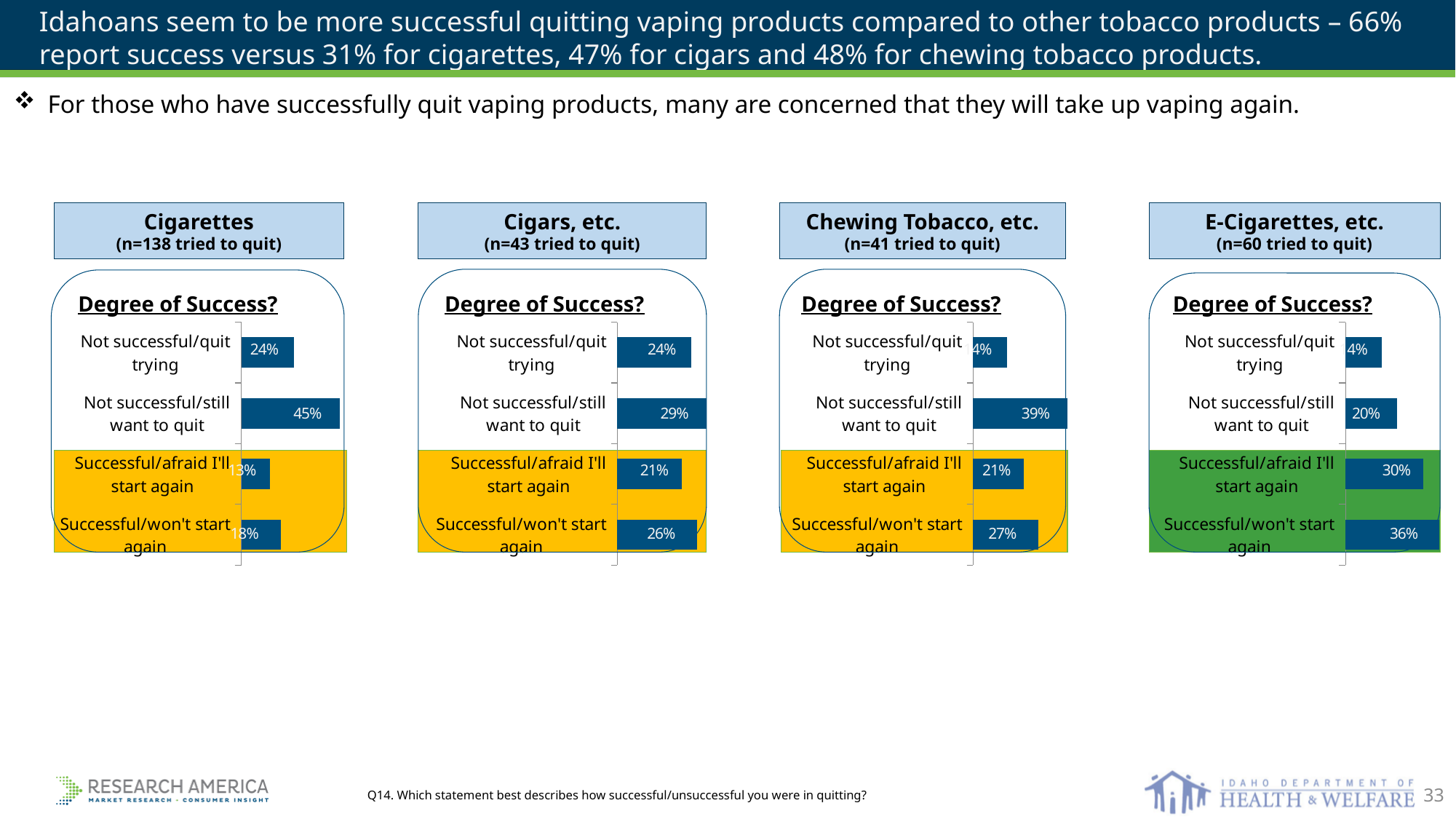
In the E-Cigarettes, etc. chart, what percentage were successful and won't start again? 36% In the Cigars, etc. chart, what is the difference between 'Not successful/still want to quit' and 'Successful/afraid I'll start again'? 8% In the Cigarettes chart, what percentage were not successful but still want to quit? 45% In the Cigarettes chart, which category has the lowest value? Successful/afraid I'll start again In the Cigarettes chart, what percentage were successful but afraid they'll start again? 13% In the E-Cigarettes, etc. chart, which category has the highest value? Successful/won't start again How many categories does each Degree of Success chart show? 4 In the Chewing Tobacco, etc. chart, what percentage were not successful but still want to quit? 39% In the Cigars, etc. chart, what percentage were successful and won't start again? 26% In the Cigarettes chart, which category has the highest value? Not successful/still want to quit What type of chart is used for the Degree of Success charts? Bar chart Which is larger: 'Successful/won't start again' in the Chewing Tobacco, etc. chart or in the E-Cigarettes, etc. chart? E-Cigarettes, etc.